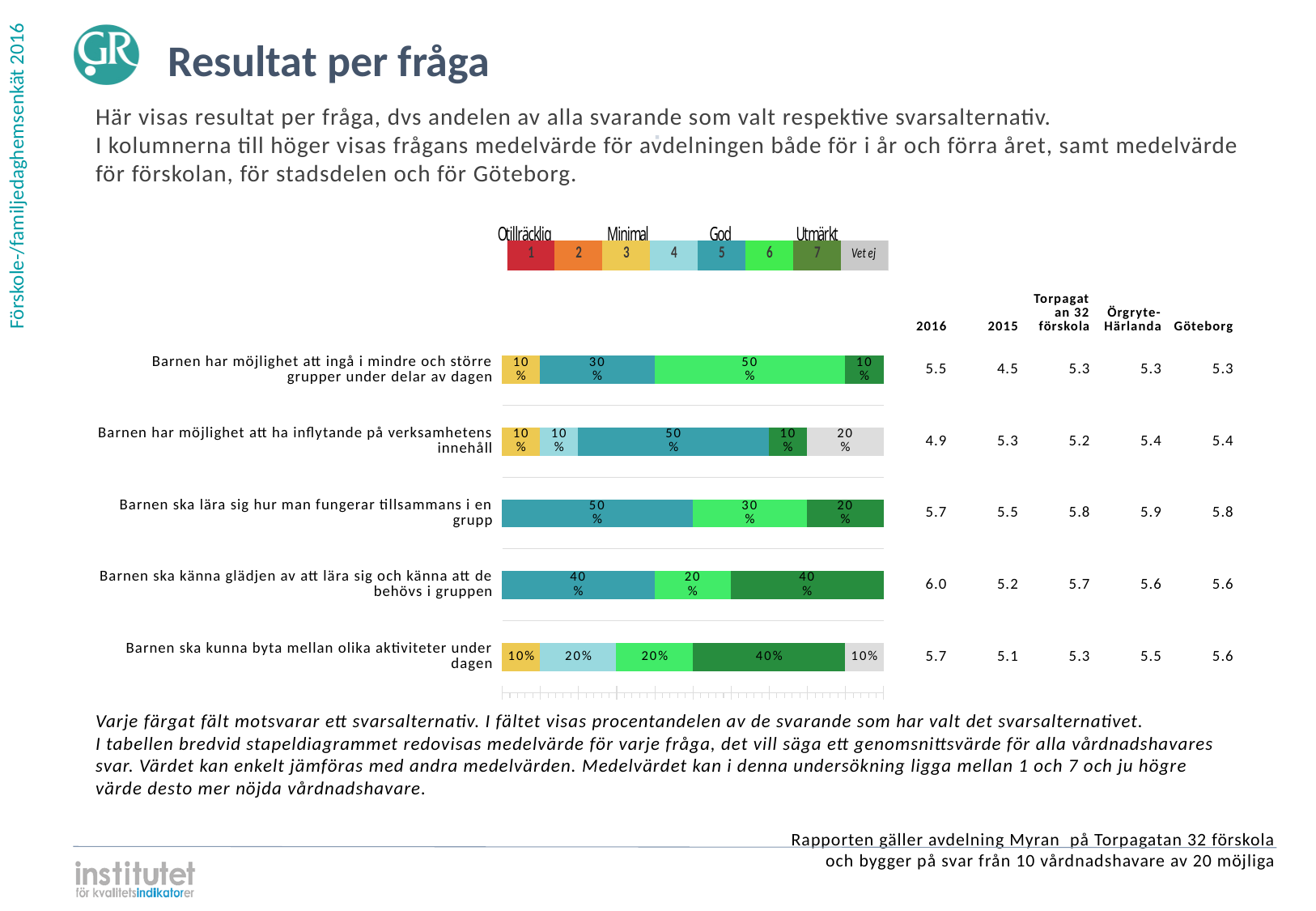
How many questions (bars) are shown in the chart? 5 For 'Barnen ska känna glädjen av att lära sig och känna att de behövs i gruppen', which is larger: the share for option 5 (teal) or option 6 (bright green)? Option 5 (teal) What label does the legend give to answer options 1 and 2 (red and orange)? Otillräcklig What percentage of respondents chose option 7 (dark green) for 'Barnen ska kunna byta mellan olika aktiviteter under dagen'? 40% What is the 2016 mean value shown for 'Barnen ska känna glädjen av att lära sig och känna att de behövs i gruppen'? 6.0 For 'Barnen ska kunna byta mellan olika aktiviteter under dagen', what is the difference between the share for option 7 (dark green) and the share for option 4 (light blue)? 20% What percentage of respondents chose option 5 (teal) for 'Barnen ska lära sig hur man fungerar tillsammans i en grupp'? 50% What percentage of respondents answered 'Vet ej' for 'Barnen har möjlighet att ha inflytande på verksamhetens innehåll'? 20% What kind of chart is used to show the share of respondents per answer option? Stacked bar chart What percentage of respondents chose option 6 (bright green) for 'Barnen har möjlighet att ingå i mindre och större grupper under delar av dagen'? 50% How many answer options does the legend above the chart list? 8 Which answer option has the largest share for 'Barnen har möjlighet att ha inflytande på verksamhetens innehåll'? Option 5 (teal), 50%